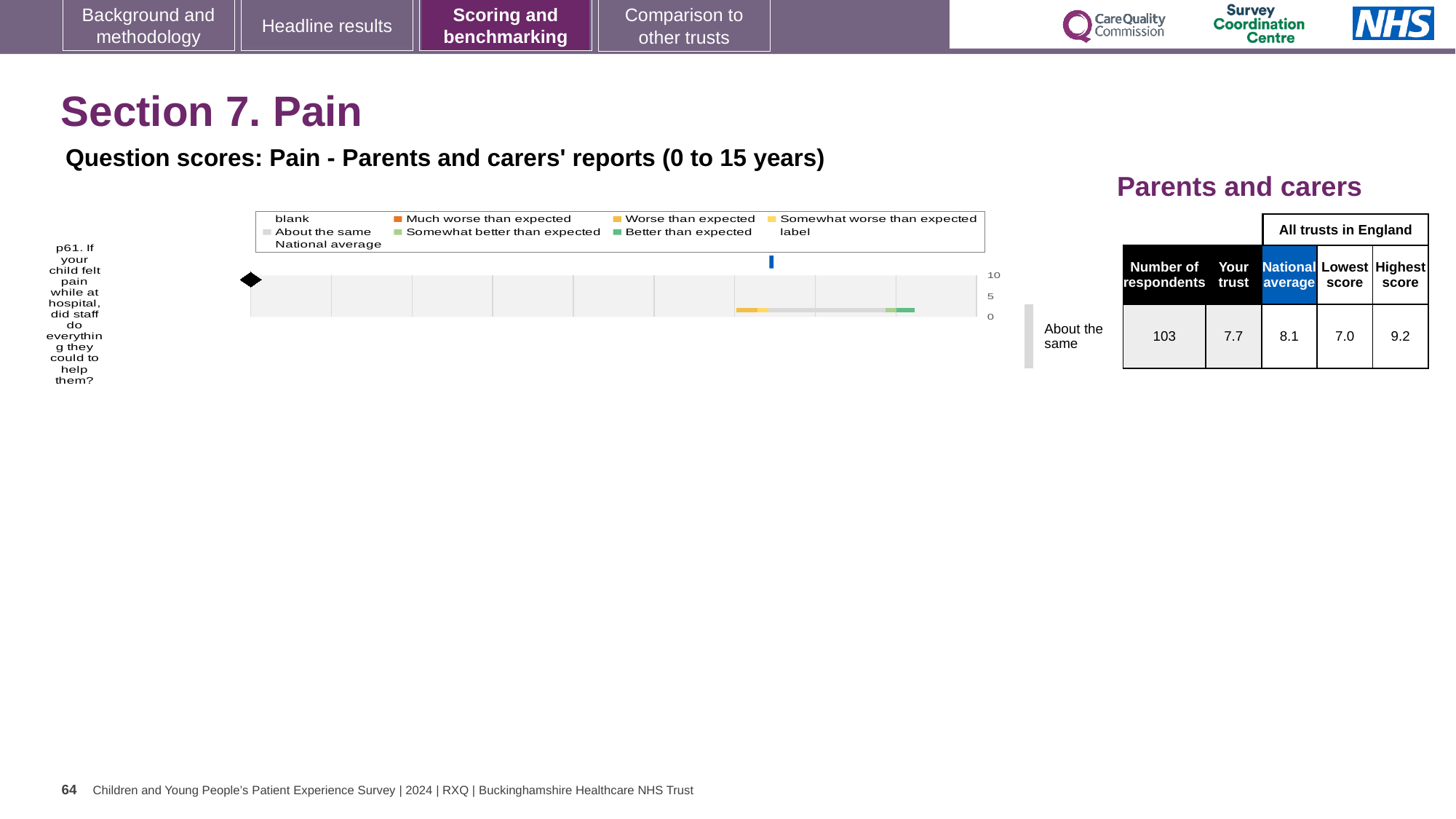
What kind of chart is used to show the question score for p61? bar chart What is the difference between the highest and lowest scores across all trusts in England for question p61? 2.2 Which benchmarking category is the trust's result for question p61 placed in? About the same What is the difference between the national average and the trust's score for question p61? 0.4 What is the highest value shown on the chart's score axis? 10 How many respondents answered question p61? 103 What is the lowest score among all trusts in England for question p61? 7.0 What is the national average score for question p61? 8.1 How many survey questions are plotted in the chart? 1 Which is larger for question p61, the trust's score or the national average? national average What is the highest score among all trusts in England for question p61? 9.2 What is the 'Your trust' score for question p61 shown alongside the chart? 7.7